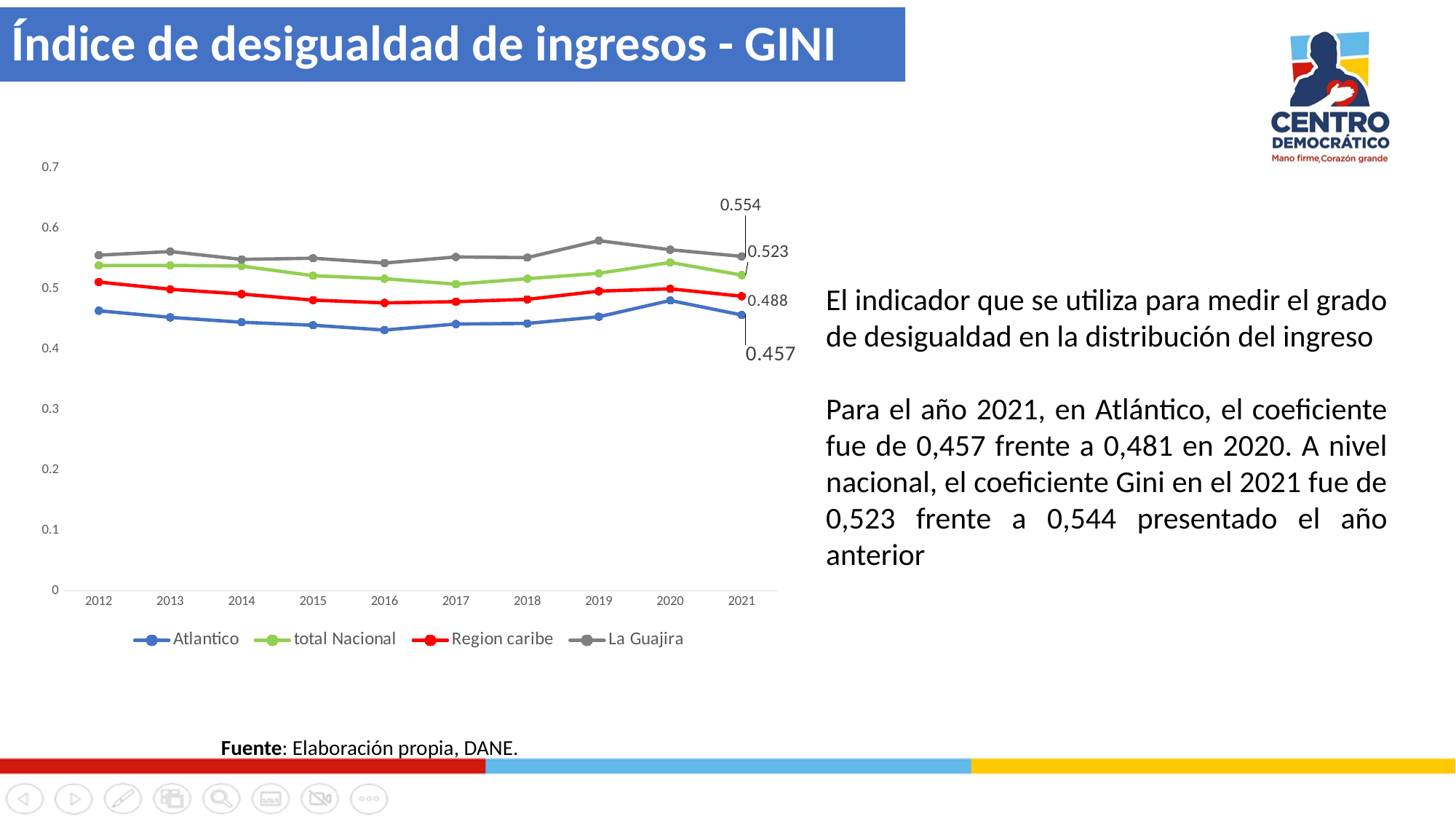
What is the value for Region caribe in 2021? 0.488 What is the value for Atlantico in 2021? 0.457 Which colour is used for the Region caribe series in the chart? red Is the value for Atlantico in 2016 greater or less than 0.5? less What is the difference between the La Guajira and Atlantico values in 2021? 0.097 What is the value for La Guajira in 2021? 0.554 What is the value for total Nacional in 2021? 0.523 Which series has the highest value in 2021? La Guajira Which series has the lowest value in 2021? Atlantico What kind of chart is shown on the slide? line chart How many years are shown on the x axis of the chart? 10 How many series does the chart legend list? 4